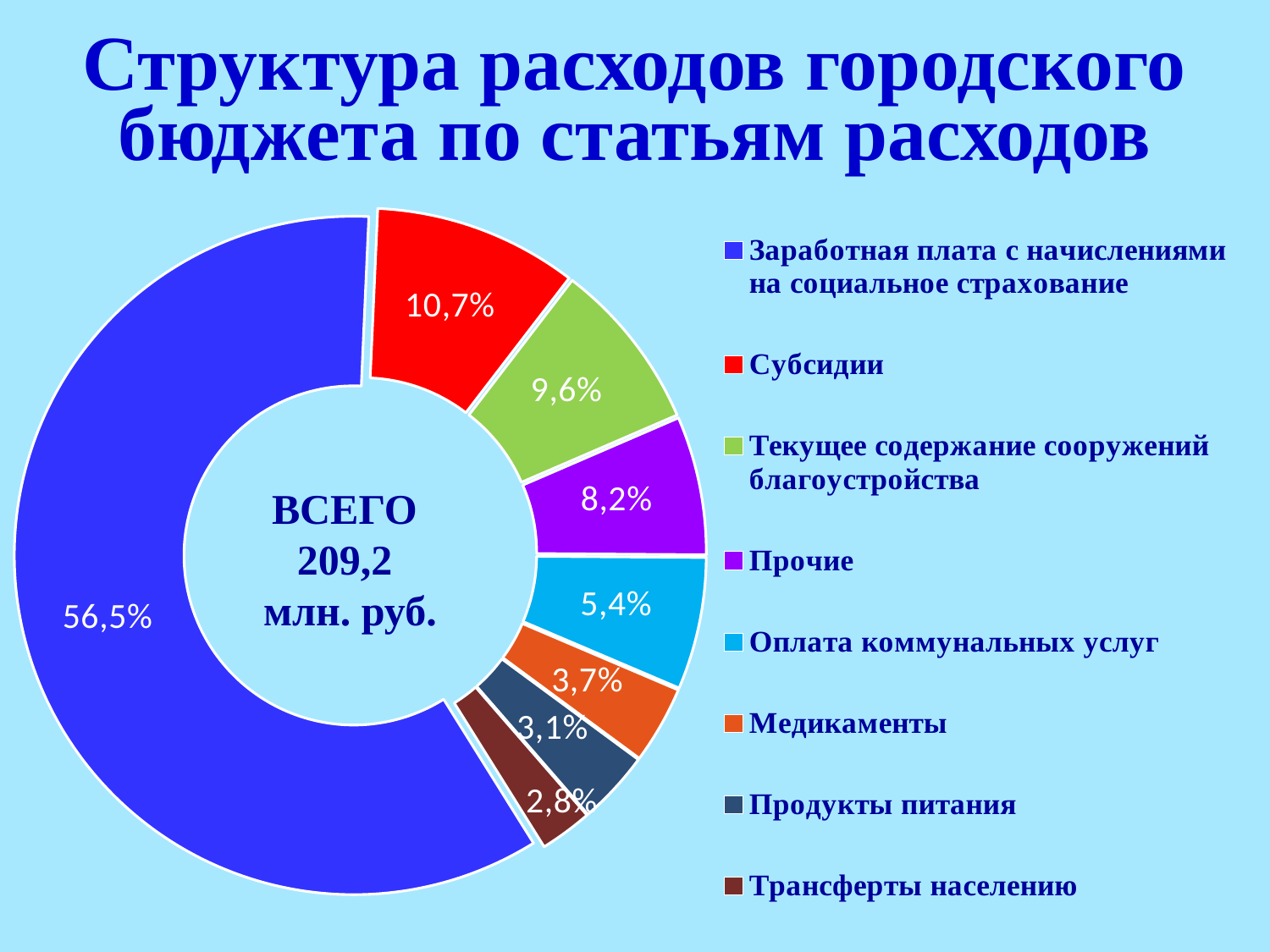
Какая доля расходов приходится на заработную плату с начислениями на социальное страхование? 56,5% Какой тип диаграммы показан на слайде? Кольцевая диаграмма Какая доля расходов приходится на субсидии? 10,7% Какая доля расходов приходится на оплату коммунальных услуг? 5,4% Сколько статей расходов показано на диаграмме? 8 На сколько процентных пунктов доля субсидий больше доли текущего содержания сооружений благоустройства? 1,1 Каким цветом на диаграмме обозначены «Прочие» расходы? Фиолетовым Какая доля расходов приходится на трансферты населению? 2,8% Какая статья расходов имеет наибольшую долю? Заработная плата с начислениями на социальное страхование Какая статья расходов имеет наименьшую долю? Трансферты населению Какая общая сумма расходов указана в центре диаграммы? 209,2 млн. руб. Что больше: доля медикаментов или доля продуктов питания? Медикаменты